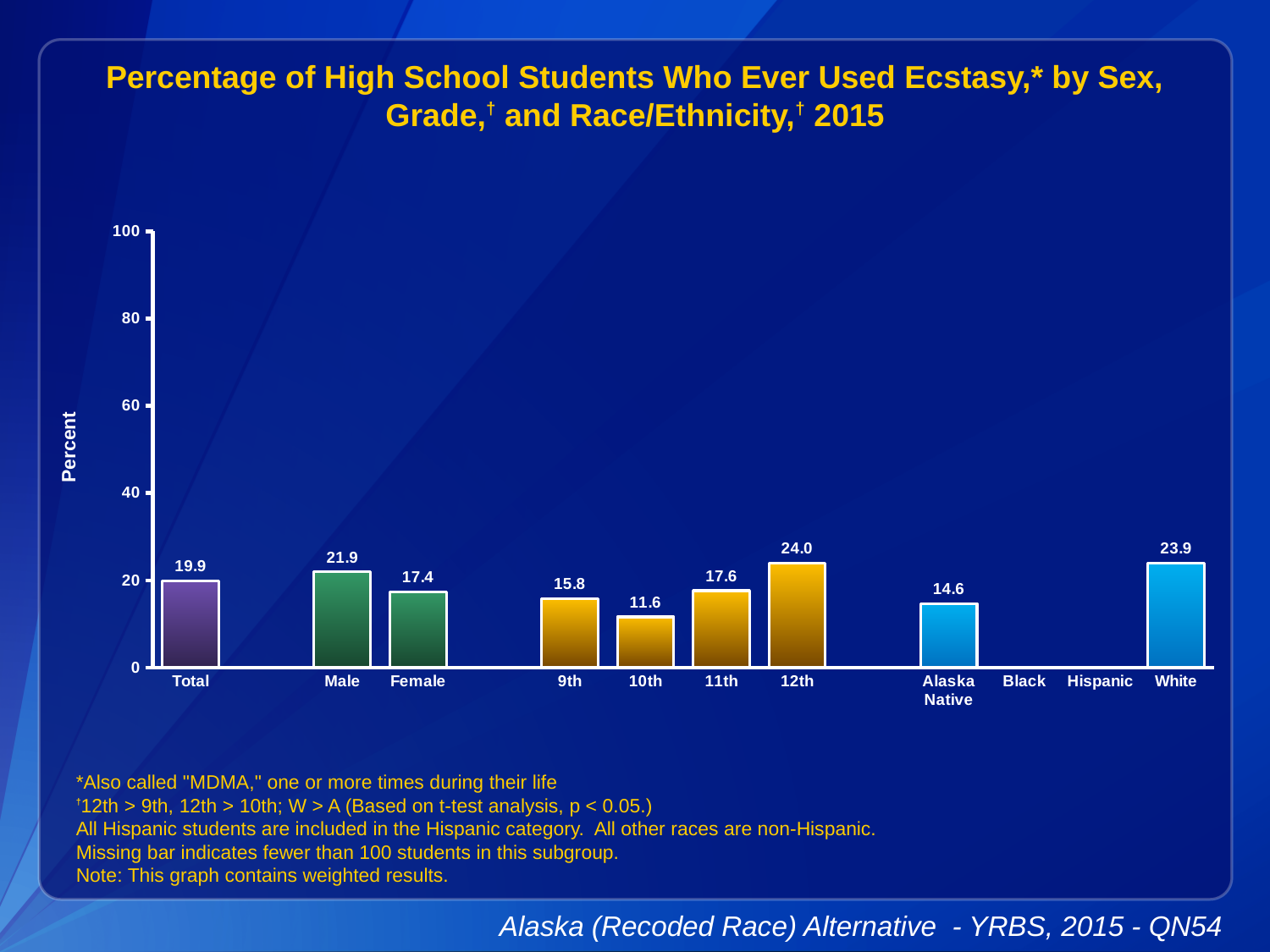
What is the value for Female? 17.4 Is the value for White greater or less than 20? greater What is the value for Alaska Native? 14.6 Which category with a bar has the lowest value? 10th Which categories have no bar shown? Black and Hispanic What is the difference between the Male and Female values? 4.5 How many categories have a bar plotted? 9 What is the value for Total? 19.9 Which is larger, the value for 9th grade or 11th grade? 11th Which category has the highest value? 12th What kind of chart is shown? bar chart What is the value for 10th grade? 11.6